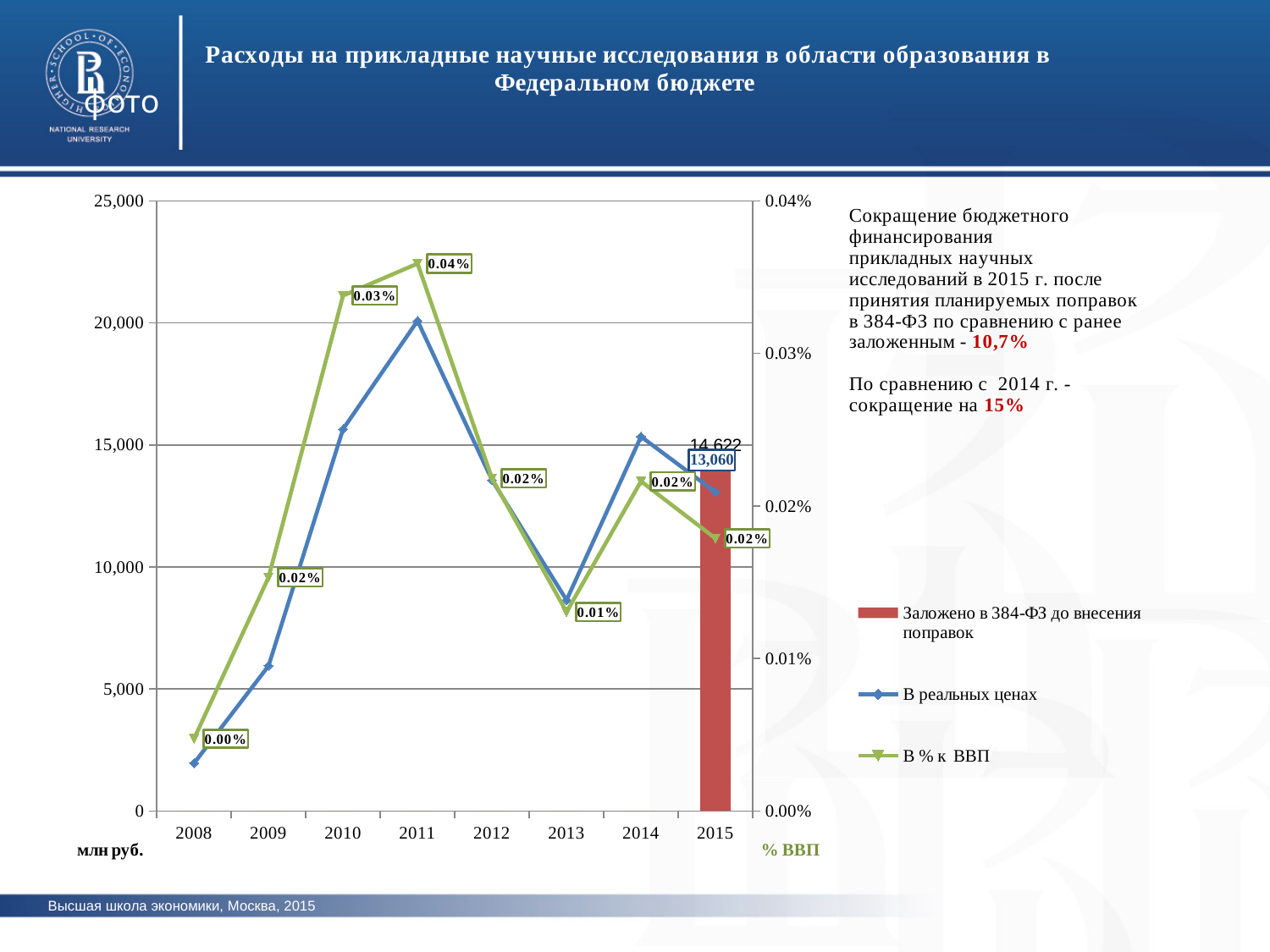
Does the 'В реальных ценах' series rise or fall from 2008 to 2011? rise What is the value of the 'В % к ВВП' series for 2013? 0.01% What is the labelled value of the 'В реальных ценах' series for 2015? 13,060 How many years are shown on the x axis? 8 How many series does the legend list? 3 Is the value of 'В реальных ценах' for 2011 greater or less than 15,000? greater What is the value of the 'В % к ВВП' series for 2011? 0.04% What value is labelled on the red bar 'Заложено в 384-ФЗ до внесения поправок' for 2015? 14,622 What is the difference between the 2015 bar value (14,622) and the 2015 'В реальных ценах' value (13,060)? 1,562 In which year does the 'В % к ВВП' series reach its highest value? 2011 In which year is the 'В % к ВВП' series at its lowest value? 2008 Which year has the larger 'В реальных ценах' value, 2011 or 2013? 2011